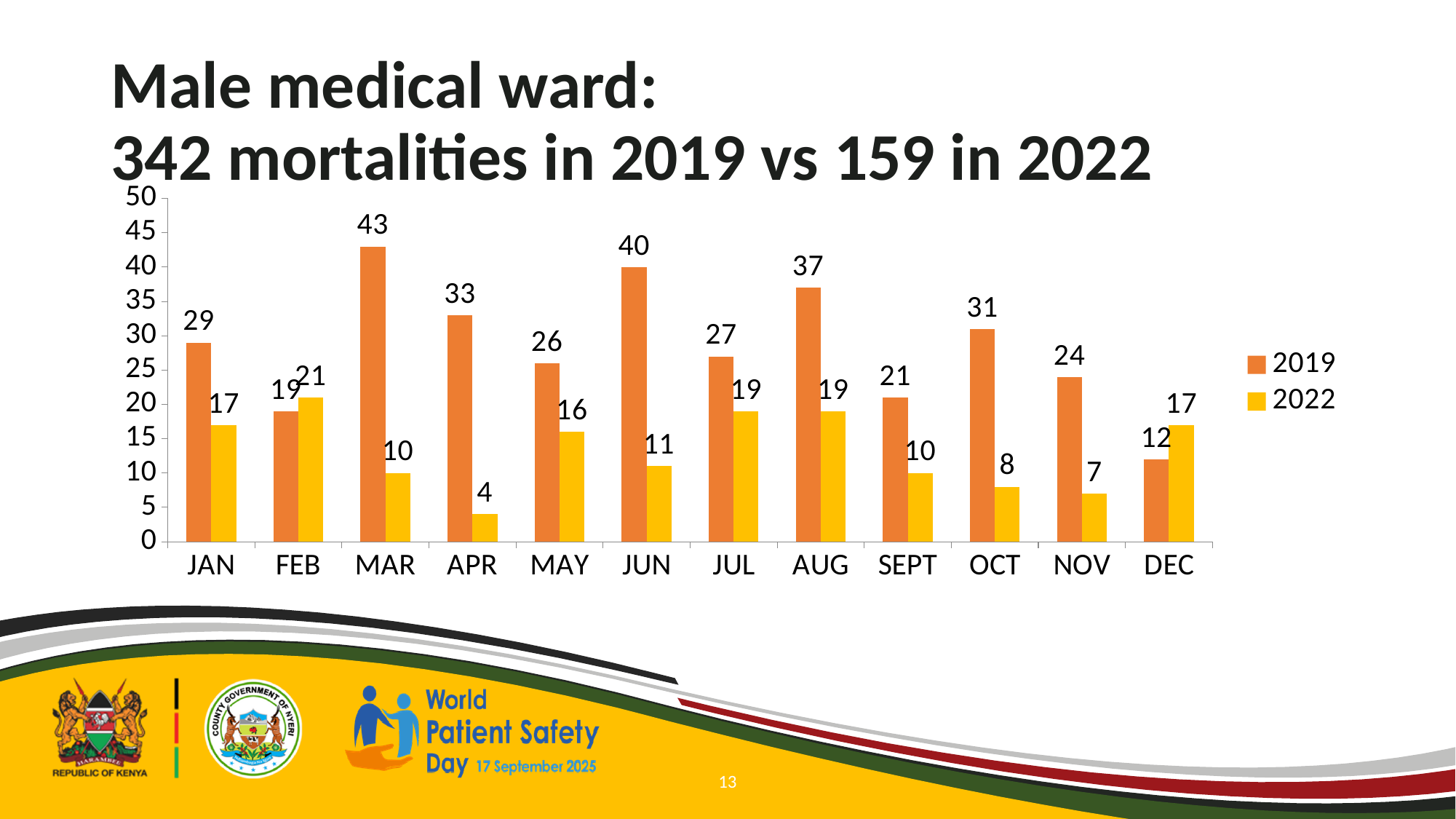
Is the value for 2019 in AUG greater or less than 35? greater What is the value for 2022 in APR? 4 Which month has the lowest value for the 2022 series? APR What kind of chart is shown on the slide? bar chart In FEB, which series has the larger value, 2019 or 2022? 2022 How many series does the legend list? 2 What is the difference between the 2019 and 2022 values in JUN? 29 Which month has the highest value for the 2019 series? MAR What is the value for 2019 in MAR? 43 Which colour represents the 2022 series in the legend? yellow What is the value for 2022 in DEC? 17 How many months are shown on the x axis? 12